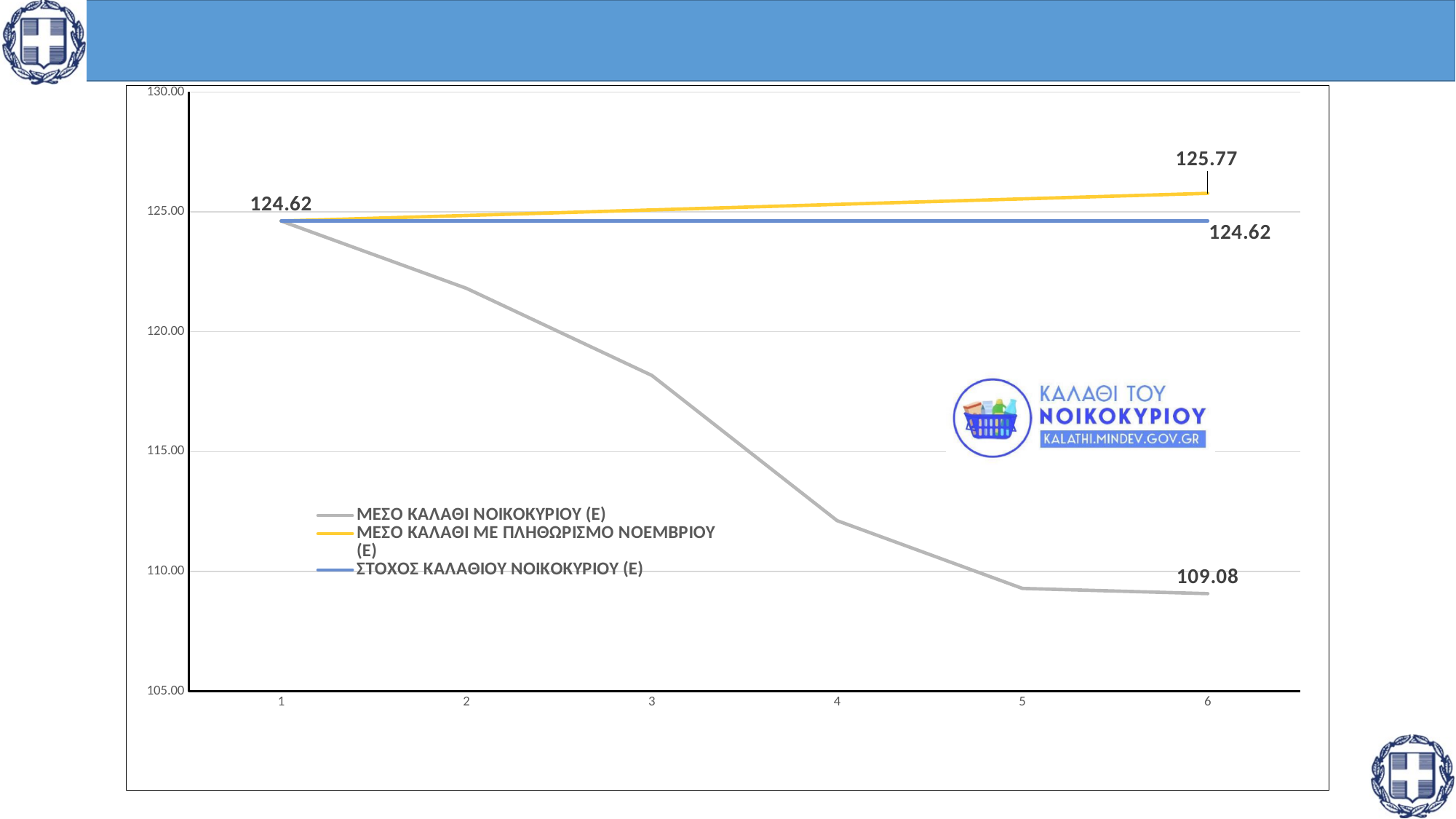
Does the ΜΕΣΟ ΚΑΛΑΘΙ ΝΟΙΚΟΚΥΡΙΟΥ (€) line rise or fall from point 1 to point 6? fall What kind of chart is shown on the slide? line chart Does the ΜΕΣΟ ΚΑΛΑΘΙ ΜΕ ΠΛΗΘΩΡΙΣΜΟ ΝΟΕΜΒΡΙΟΥ (€) line rise or fall from point 1 to point 6? rise What value is labelled at point 1 on the chart? 124.62 What is the value of ΜΕΣΟ ΚΑΛΑΘΙ ΝΟΙΚΟΚΥΡΙΟΥ (€) at point 6? 109.08 Is the value of ΜΕΣΟ ΚΑΛΑΘΙ ΝΟΙΚΟΚΥΡΙΟΥ (€) at point 4 greater or less than 115.00? less How many series does the legend list? 3 What is the value of ΣΤΟΧΟΣ ΚΑΛΑΘΙΟΥ ΝΟΙΚΟΚΥΡΙΟΥ (€) at point 6? 124.62 What is the difference between ΜΕΣΟ ΚΑΛΑΘΙ ΜΕ ΠΛΗΘΩΡΙΣΜΟ ΝΟΕΜΒΡΙΟΥ (€) and ΜΕΣΟ ΚΑΛΑΘΙ ΝΟΙΚΟΚΥΡΙΟΥ (€) at point 6? 16.69 At point 6, which is larger: ΜΕΣΟ ΚΑΛΑΘΙ ΜΕ ΠΛΗΘΩΡΙΣΜΟ ΝΟΕΜΒΡΙΟΥ (€) or ΣΤΟΧΟΣ ΚΑΛΑΘΙΟΥ ΝΟΙΚΟΚΥΡΙΟΥ (€)? ΜΕΣΟ ΚΑΛΑΘΙ ΜΕ ΠΛΗΘΩΡΙΣΜΟ ΝΟΕΜΒΡΙΟΥ (€) What is the value of ΜΕΣΟ ΚΑΛΑΘΙ ΜΕ ΠΛΗΘΩΡΙΣΜΟ ΝΟΕΜΒΡΙΟΥ (€) at point 6? 125.77 How many points are there along the x axis? 6